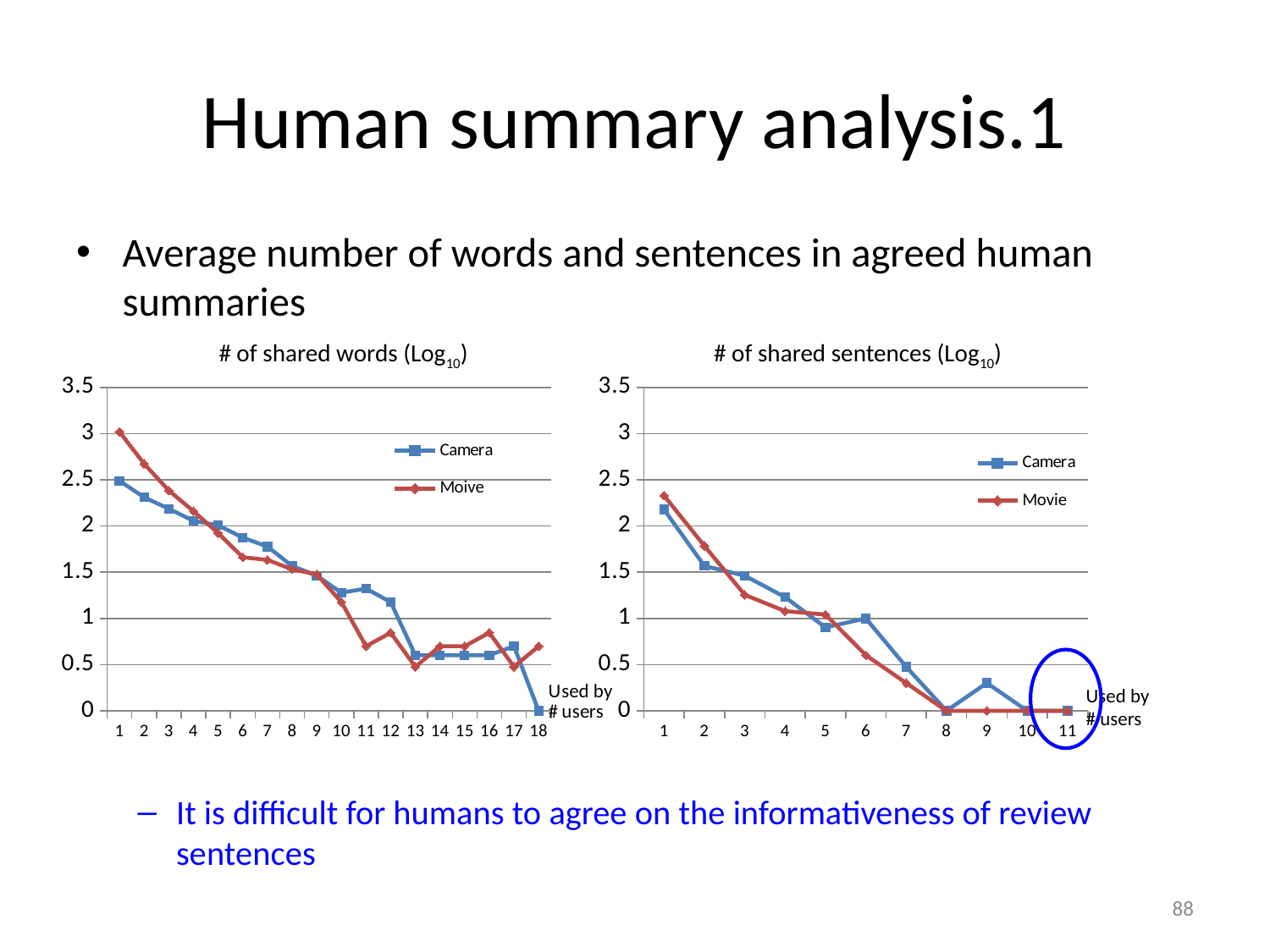
In the '# of shared sentences (Log10)' chart, which series has the larger value at 9 users, Camera or Movie? Camera In the '# of shared sentences (Log10)' chart, is the Movie value at 1 user greater or less than 2? greater How many x-axis points are plotted in the '# of shared sentences (Log10)' chart? 11 How many x-axis points are plotted in the '# of shared words (Log10)' chart? 18 How many series does the legend of the '# of shared words (Log10)' chart list? 2 In the '# of shared words (Log10)' chart, which series has the larger value at 1 user, Camera or Movie? Movie In the '# of shared words (Log10)' chart, do the Camera values generally rise or fall as the number of users increases? fall In the '# of shared words (Log10)' chart, is the Movie value at 1 user greater or less than 2.5? greater In the '# of shared sentences (Log10)' chart, what is the Camera value at 11 users? 0 What kind of chart is the '# of shared words (Log10)' chart on the left? line chart In the '# of shared words (Log10)' chart, is the Camera value at 11 users greater or less than 1? greater What are the two legend entries in the '# of shared sentences (Log10)' chart? Camera and Movie